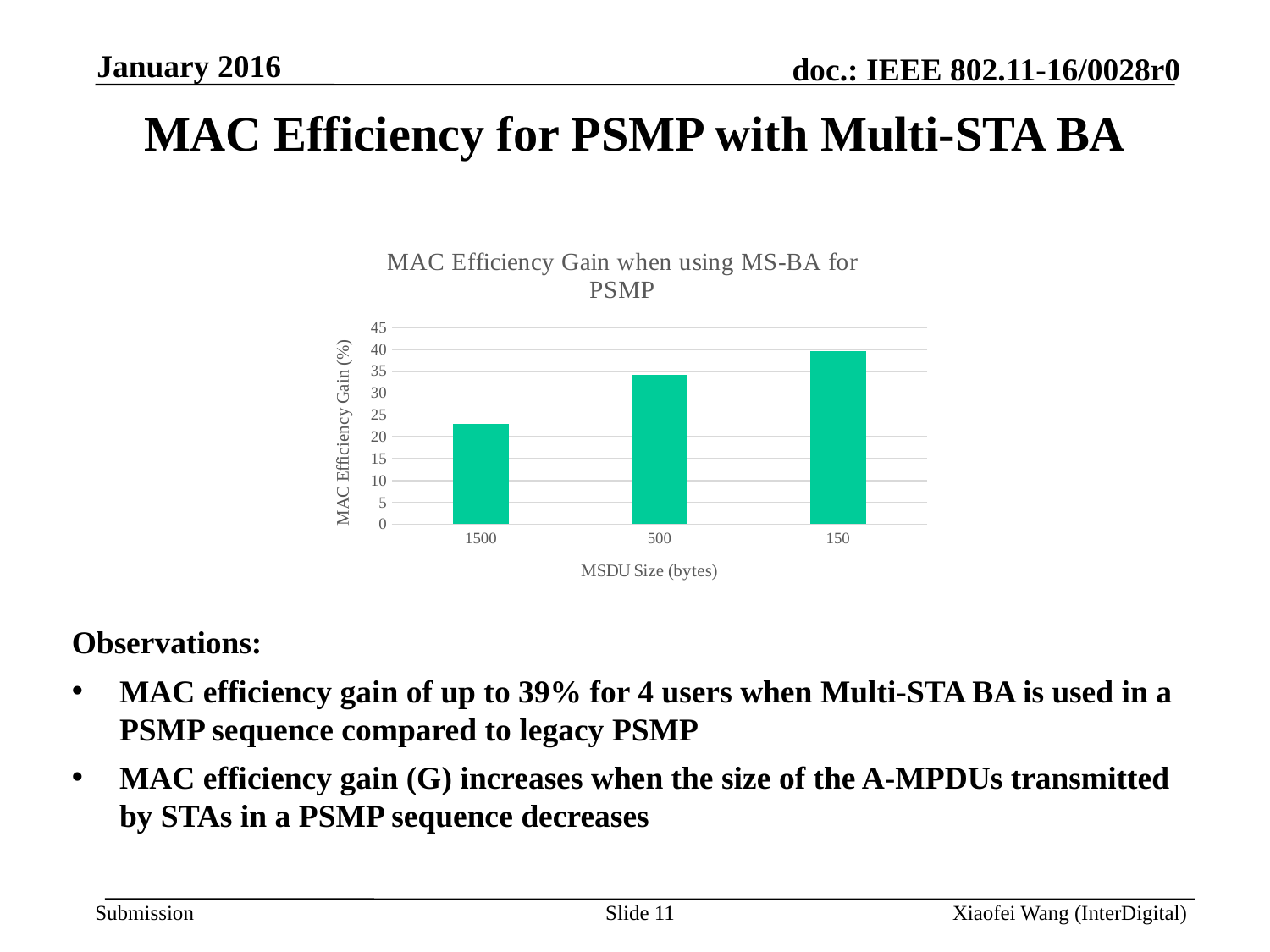
Is the MAC efficiency gain for MSDU size 500 greater or less than 30? greater Is the MAC efficiency gain for MSDU size 1500 greater or less than 25? less Is the MAC efficiency gain for MSDU size 150 greater or less than 35? greater What is the label of the x axis of the chart? MSDU Size (bytes) Which has a larger MAC efficiency gain, MSDU size 500 or MSDU size 1500? 500 What kind of chart is shown on the slide? bar chart What is the title of the chart? MAC Efficiency Gain when using MS-BA for PSMP How many MSDU size categories are plotted in the chart? 3 Which MSDU size has the highest MAC efficiency gain? 150 Do the bar values rise or fall moving from left to right along the x axis? rise Which MSDU size has the lowest MAC efficiency gain? 1500